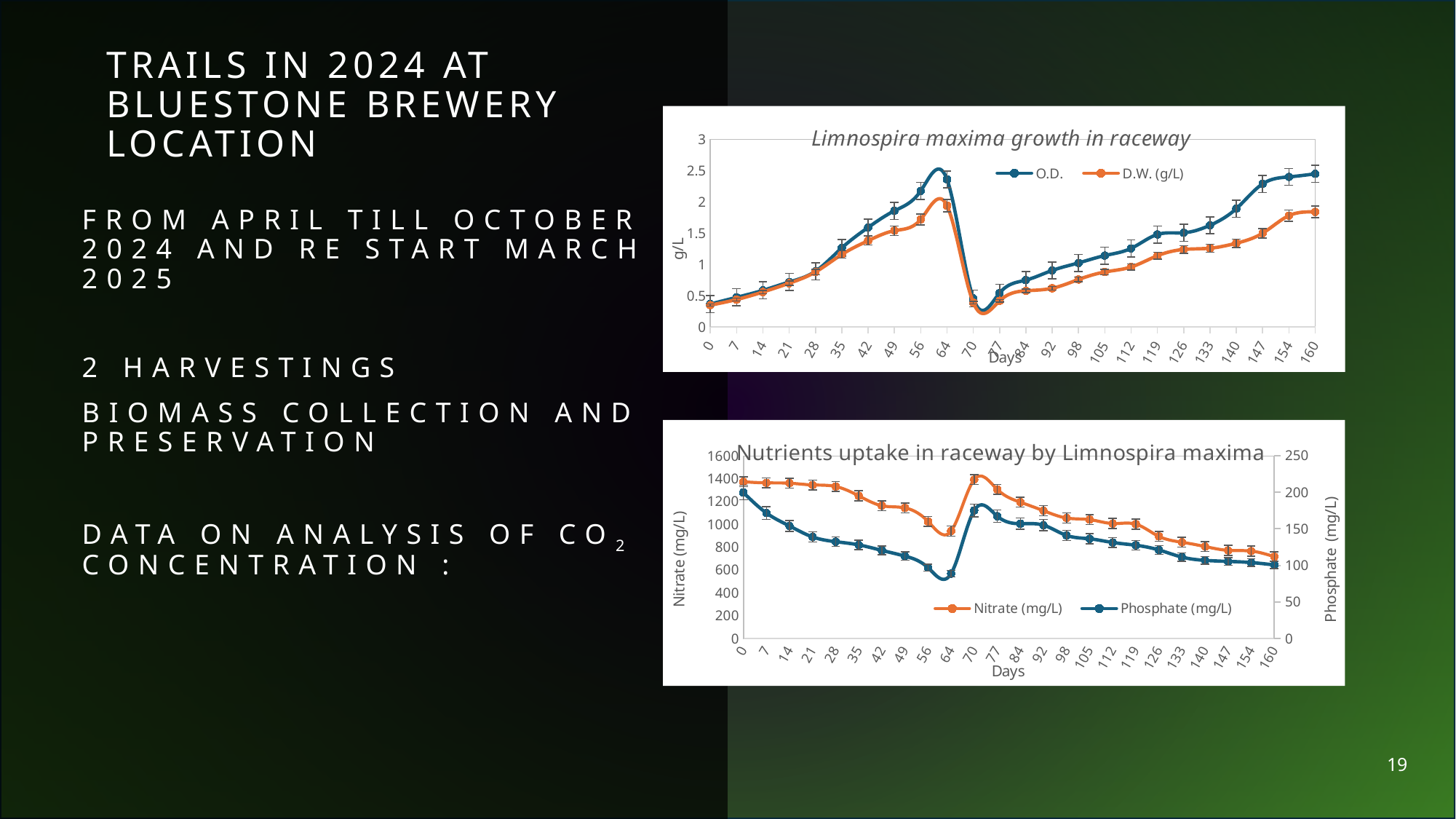
In the 'Nutrients uptake in raceway by Limnospira maxima' chart, do the Nitrate (mg/L) values rise or fall between day 0 and day 56? fall What is the label of the x axis on the 'Limnospira maxima growth in raceway' chart? Days In the 'Limnospira maxima growth in raceway' chart, is the O.D. value at day 160 greater or less than 2? greater In the 'Nutrients uptake in raceway by Limnospira maxima' chart, is the Nitrate (mg/L) value at day 160 greater or less than 800? less How many series does the legend of the 'Nutrients uptake in raceway by Limnospira maxima' chart list? 2 What kind of chart is the 'Limnospira maxima growth in raceway' chart? line chart In the 'Limnospira maxima growth in raceway' chart, which series is higher at day 160, O.D. or D.W. (g/L)? O.D. In the 'Limnospira maxima growth in raceway' chart, is the D.W. (g/L) value at day 70 greater or less than 0.5? less In the 'Limnospira maxima growth in raceway' chart, do the O.D. values rise or fall between day 0 and day 56? rise How many series does the legend of the 'Limnospira maxima growth in raceway' chart list? 2